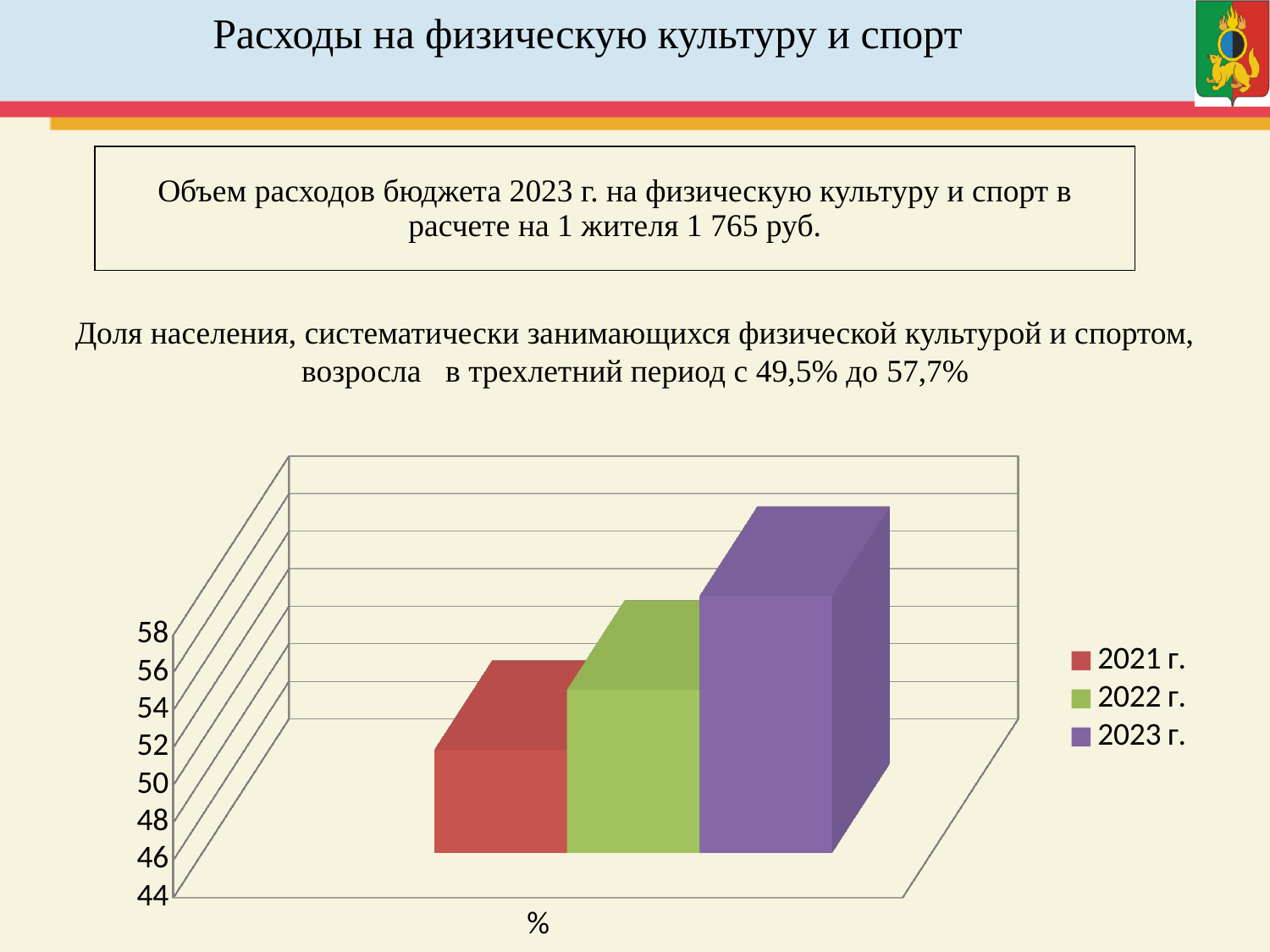
Is the value for 2022 г. greater or less than 50? greater Is the value for 2021 г. greater or less than 54? less What colour is the bar for 2023 г. in the chart? purple Which year has the highest bar in the chart? 2023 г. Is the value for 2023 г. greater or less than 54? greater Which year has the lowest bar in the chart? 2021 г. How many series does the chart legend list? 3 What kind of chart is shown on the slide? bar chart Which is larger in the chart, the value for 2022 г. or the value for 2021 г.? 2022 г. Which is larger in the chart, the value for 2023 г. or the value for 2022 г.? 2023 г. How many bars are plotted in the chart? 3 Do the bar values rise or fall from 2021 г. to 2023 г.? rise